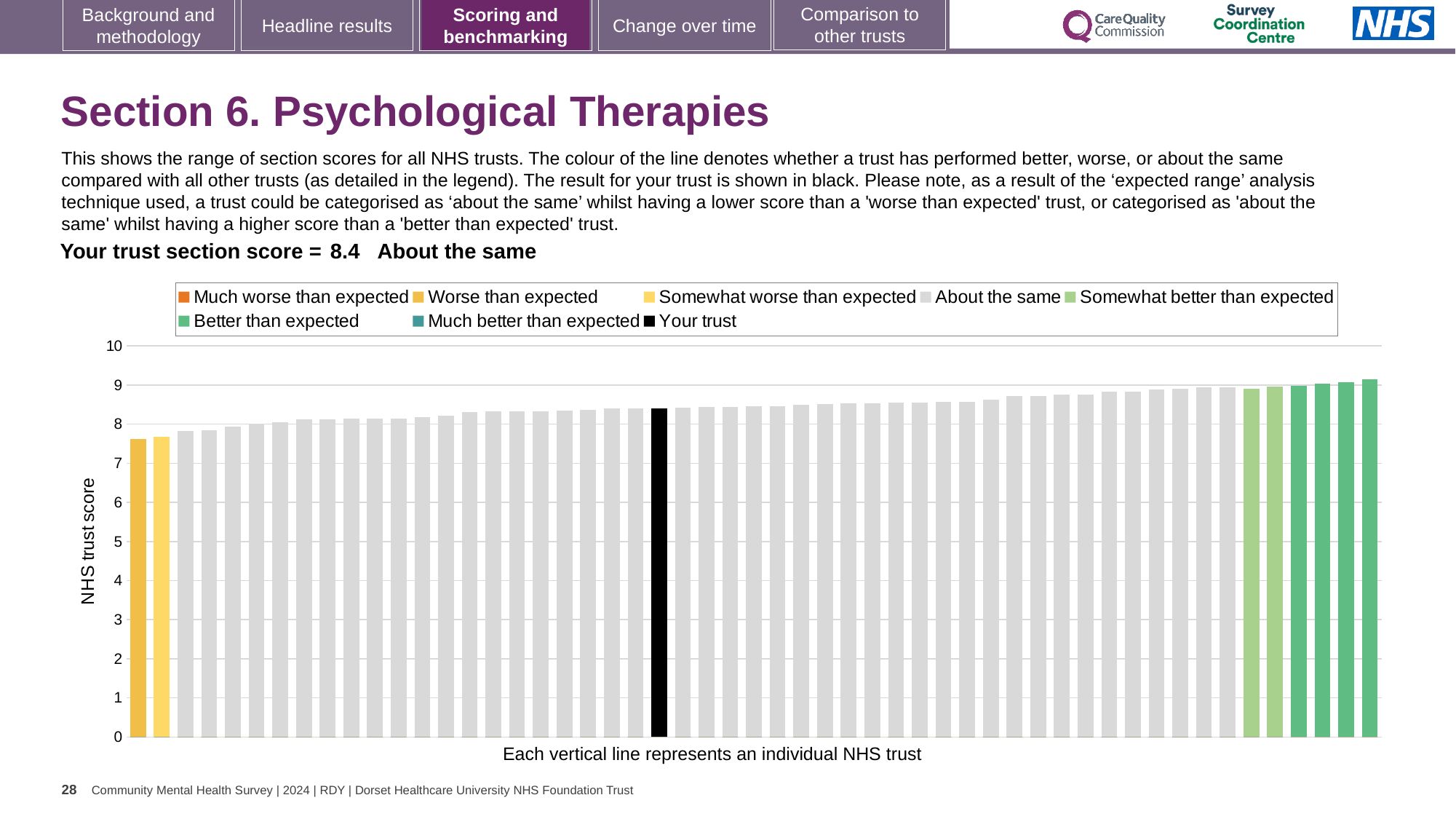
Is the value of the rightmost bar greater or less than 8? greater Do the bar values rise or fall from left to right along the x axis? rise How many entries does the chart legend list? 8 Is the value for your trust (the black bar) greater or less than 8? greater Is the value of the leftmost bar greater or less than 8? less What is the label on the y axis of the chart? NHS trust score Which category is your trust placed in according to the slide? About the same What kind of chart is shown on the slide? bar chart What is the section score for your trust shown on the slide? 8.4